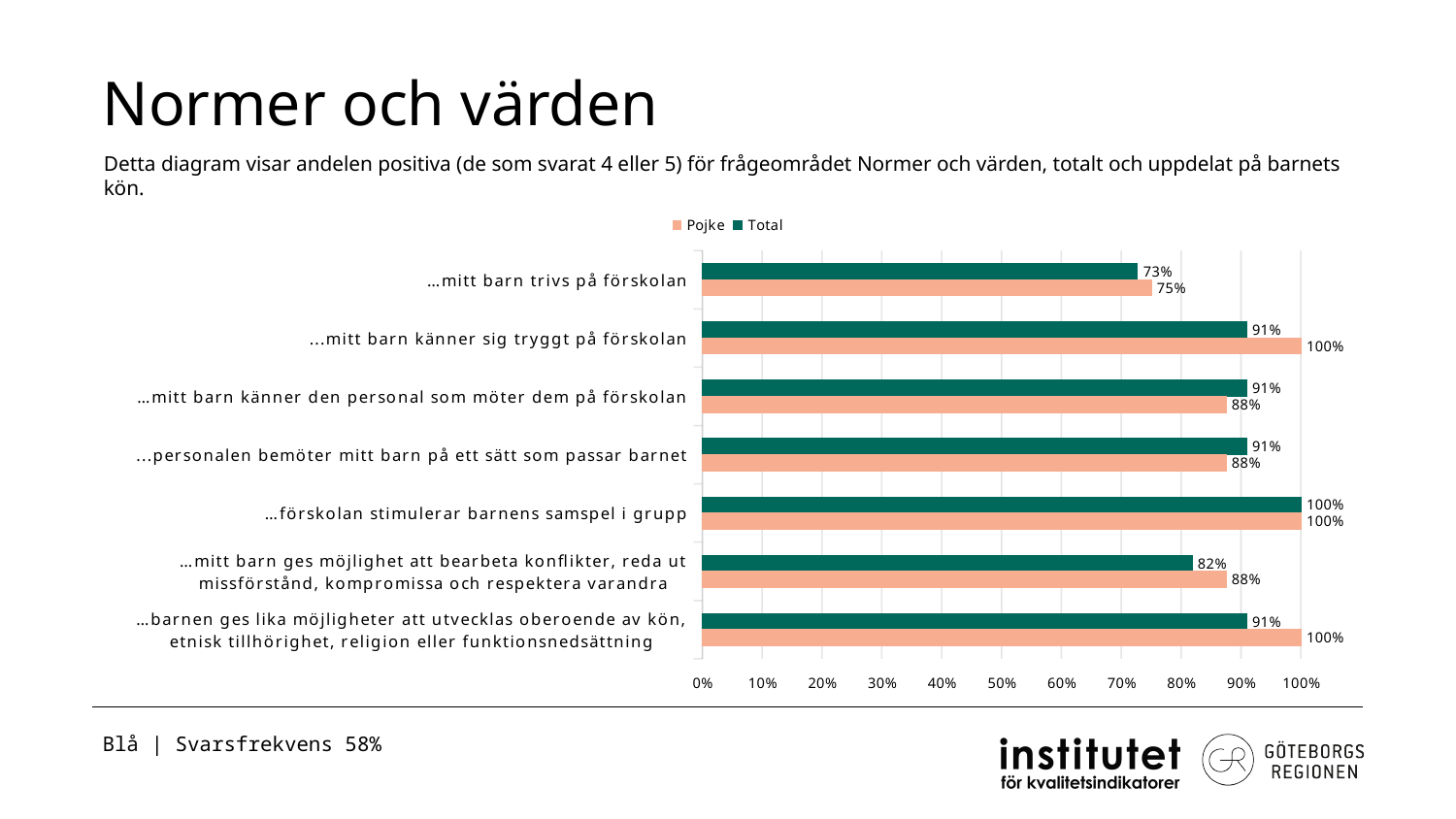
Which category has the lowest Total value? …mitt barn trivs på förskolan How many series does the legend list? 2 What is the Pojke value for "...mitt barn känner sig tryggt på förskolan"? 100% For "…mitt barn känner den personal som möter dem på förskolan", which is larger, the Pojke value or the Total value? Total How many categories are shown on the chart? 7 What is the Total value for "…mitt barn ges möjlighet att bearbeta konflikter, reda ut missförstånd, kompromissa och respektera varandra"? 82% What is the Total value for "…mitt barn trivs på förskolan"? 73% What kind of chart is shown on the slide? Bar chart Which category has the lowest Pojke value? …mitt barn trivs på förskolan What is the Pojke value for "…mitt barn trivs på förskolan"? 75% Which series is shown in green? Total What is the difference between the Pojke and Total values for "...mitt barn känner sig tryggt på förskolan"? 9 percentage points